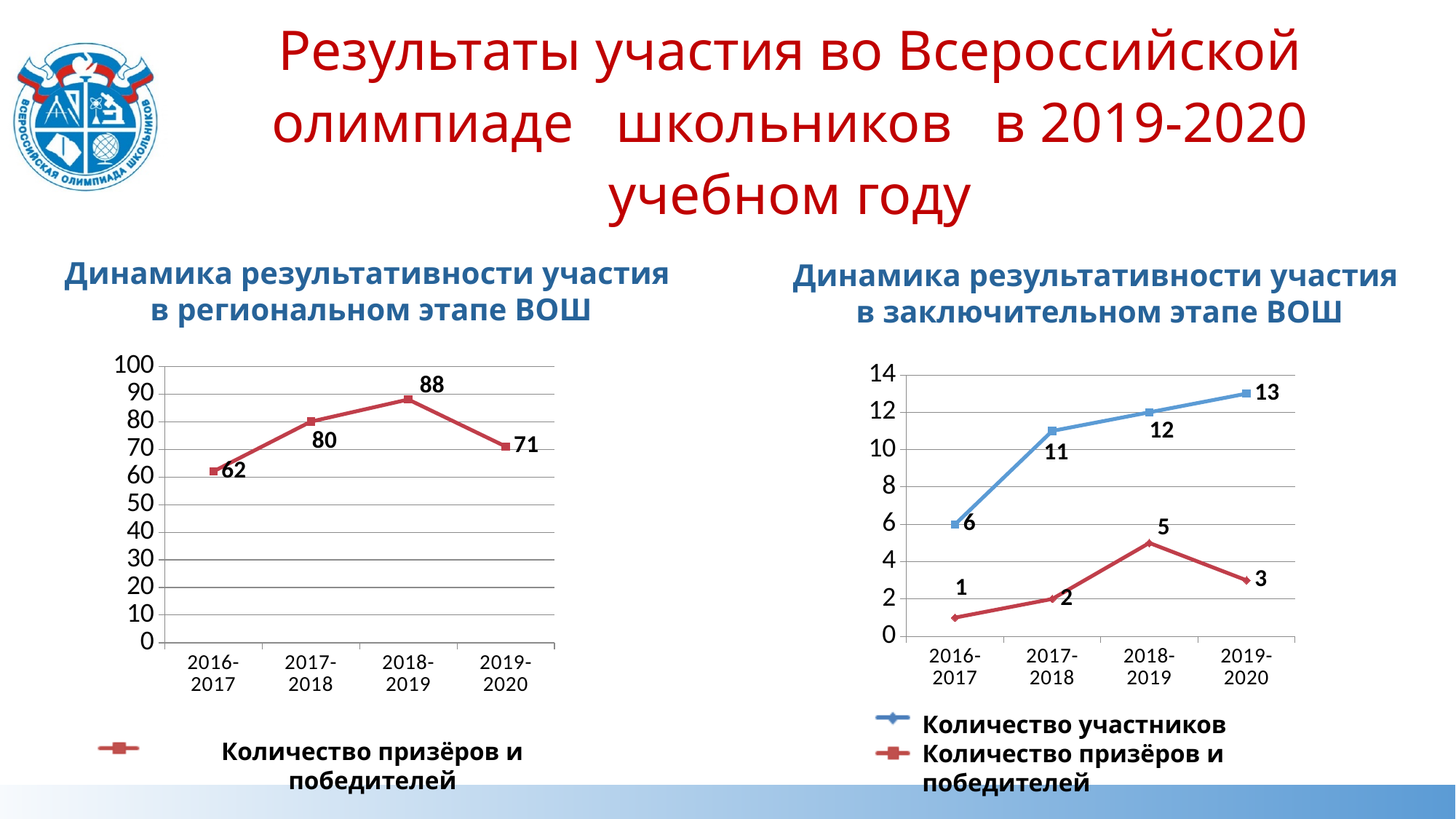
In the right chart (final stage), what is the number of participants in 2019-2020? 13 In the left chart (regional stage), what is the number of prize-winners and winners in 2018-2019? 88 What type of chart is the left chart (regional stage)? line chart In the right chart (final stage), which year has the highest number of prize-winners and winners? 2018-2019 In the right chart (final stage), what is the difference between the number of participants and the number of prize-winners and winners in 2017-2018? 9 In the left chart (regional stage), what is the difference between the values for 2018-2019 and 2019-2020? 17 In the left chart (regional stage), what is the value for 2016-2017? 62 In the right chart (final stage), how many series does the legend list? 2 In the left chart (regional stage), how many data points are plotted? 4 In the right chart (final stage), what is the number of prize-winners and winners in 2018-2019? 5 In the left chart (regional stage), which year has the lowest value? 2016-2017 In the right chart (final stage), does the number of participants rise or fall from 2016-2017 to 2019-2020? rise